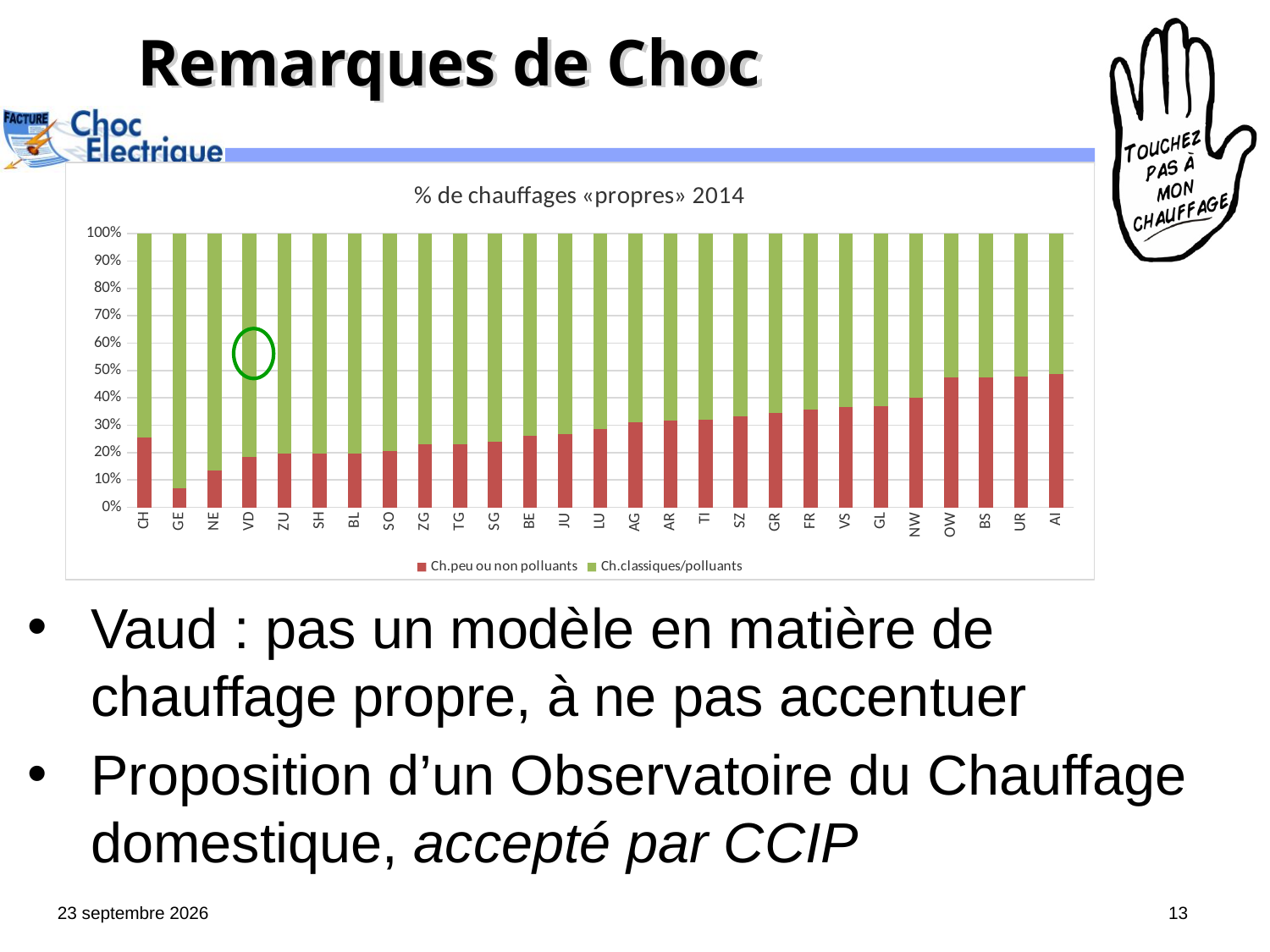
Is the 'Ch.peu ou non polluants' share for FR greater or less than 30%? greater Which has a larger 'Ch.peu ou non polluants' share, CH or GE? CH How many cantons (categories) are shown on the x axis of the chart? 27 How many series does the chart legend list? 2 What kind of chart is shown on the slide? stacked bar chart Is the 'Ch.peu ou non polluants' share for VD greater or less than 20%? less Which series is shown in red in the chart? Ch.peu ou non polluants Which canton has the lowest share of 'Ch.peu ou non polluants'? GE Is the 'Ch.peu ou non polluants' share for GE greater or less than 10%? less What does each stacked bar in the chart total? 100% Which has a larger 'Ch.peu ou non polluants' share, VD or FR? FR What is the title of the chart? % de chauffages «propres» 2014